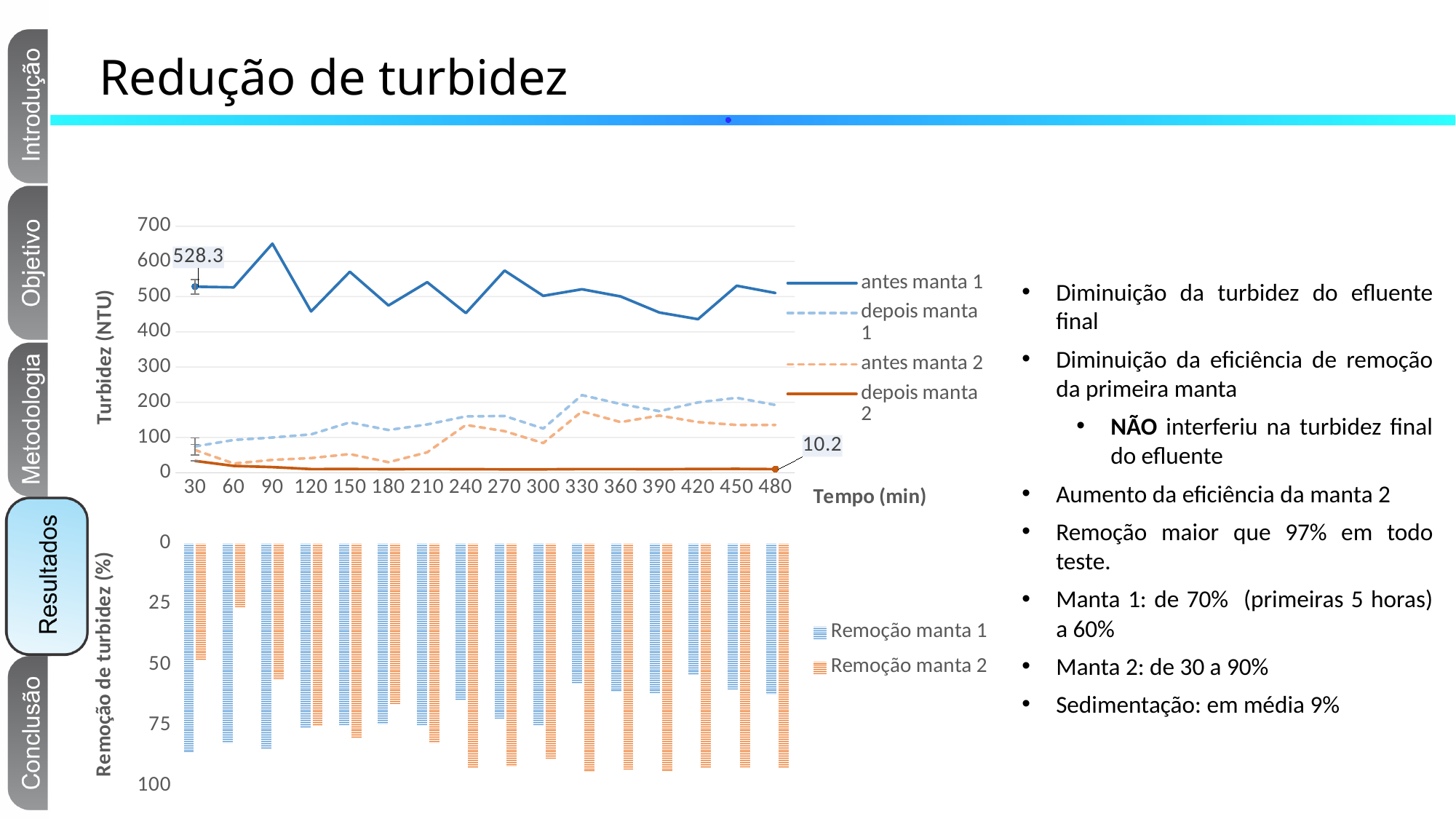
How many time points are shown on the x axis of the top chart? 16 How many series does the legend of the top chart list? 4 How many series does the legend of the bottom chart list? 2 What kind of chart is the top chart on the slide? line chart What kind of chart is the bottom chart on the slide? bar chart In the top chart, is the value of 'antes manta 2' at 30 min greater or less than 100? less In the top chart, what is the value of 'antes manta 1' at 30 min? 528.3 In the top chart, at 30 min, which is larger: 'antes manta 1' or 'depois manta 2'? antes manta 1 In the top chart, what is the value of 'depois manta 2' at 480 min? 10.2 In the top chart, is the value of 'antes manta 1' at 90 min greater or less than 600? greater What is the y-axis title of the top chart? Turbidez (NTU) In the top chart, which series has the highest values overall? antes manta 1